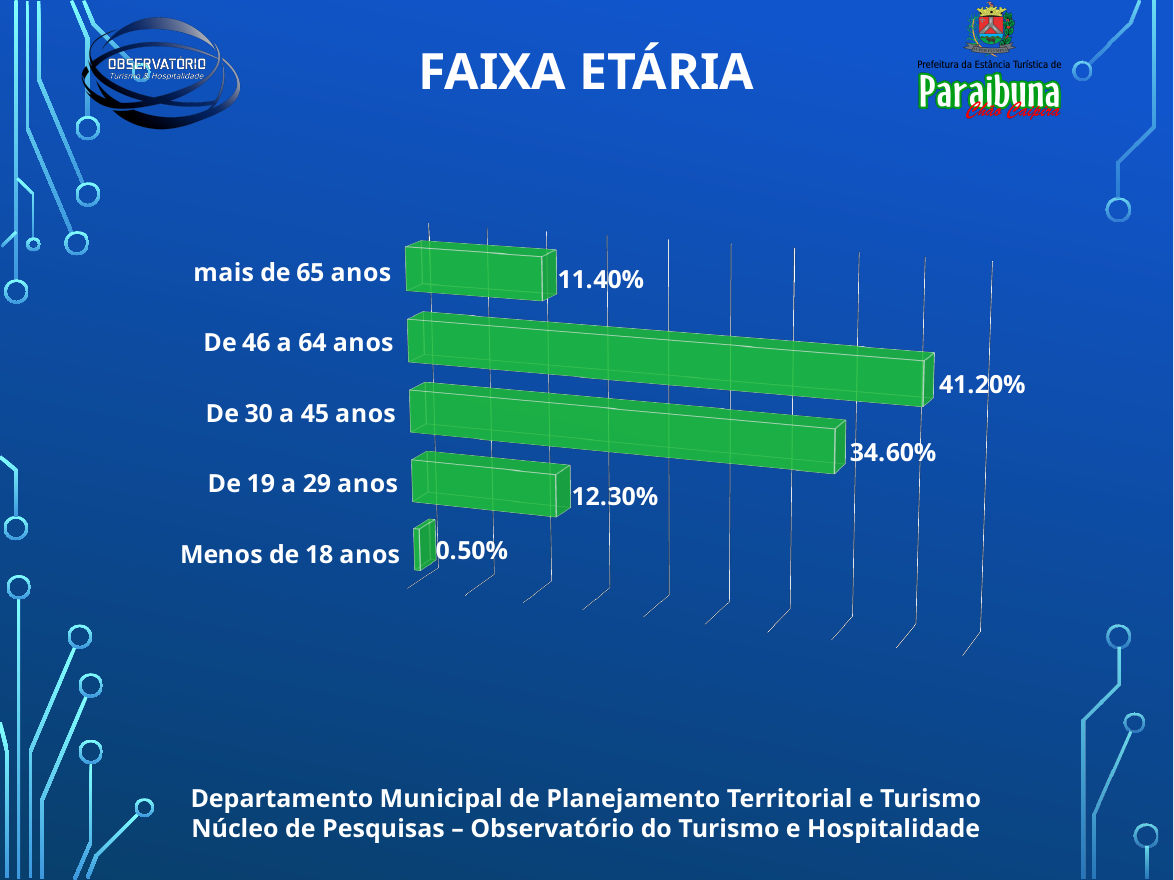
What is the difference between the values for 'De 46 a 64 anos' and 'De 30 a 45 anos'? 6.60% What is the value for 'De 19 a 29 anos'? 12.30% What colour are the bars in the chart? Green How many age groups are shown in the chart? 5 What is the title of the slide? FAIXA ETÁRIA Which is larger, the value for 'De 19 a 29 anos' or 'mais de 65 anos'? De 19 a 29 anos What is the value for 'De 46 a 64 anos'? 41.20% What kind of chart is shown on the slide? Bar chart What is the value for 'mais de 65 anos'? 11.40% Which age group has the highest value? De 46 a 64 anos What is the value for 'Menos de 18 anos'? 0.50% Which age group has the lowest value? Menos de 18 anos